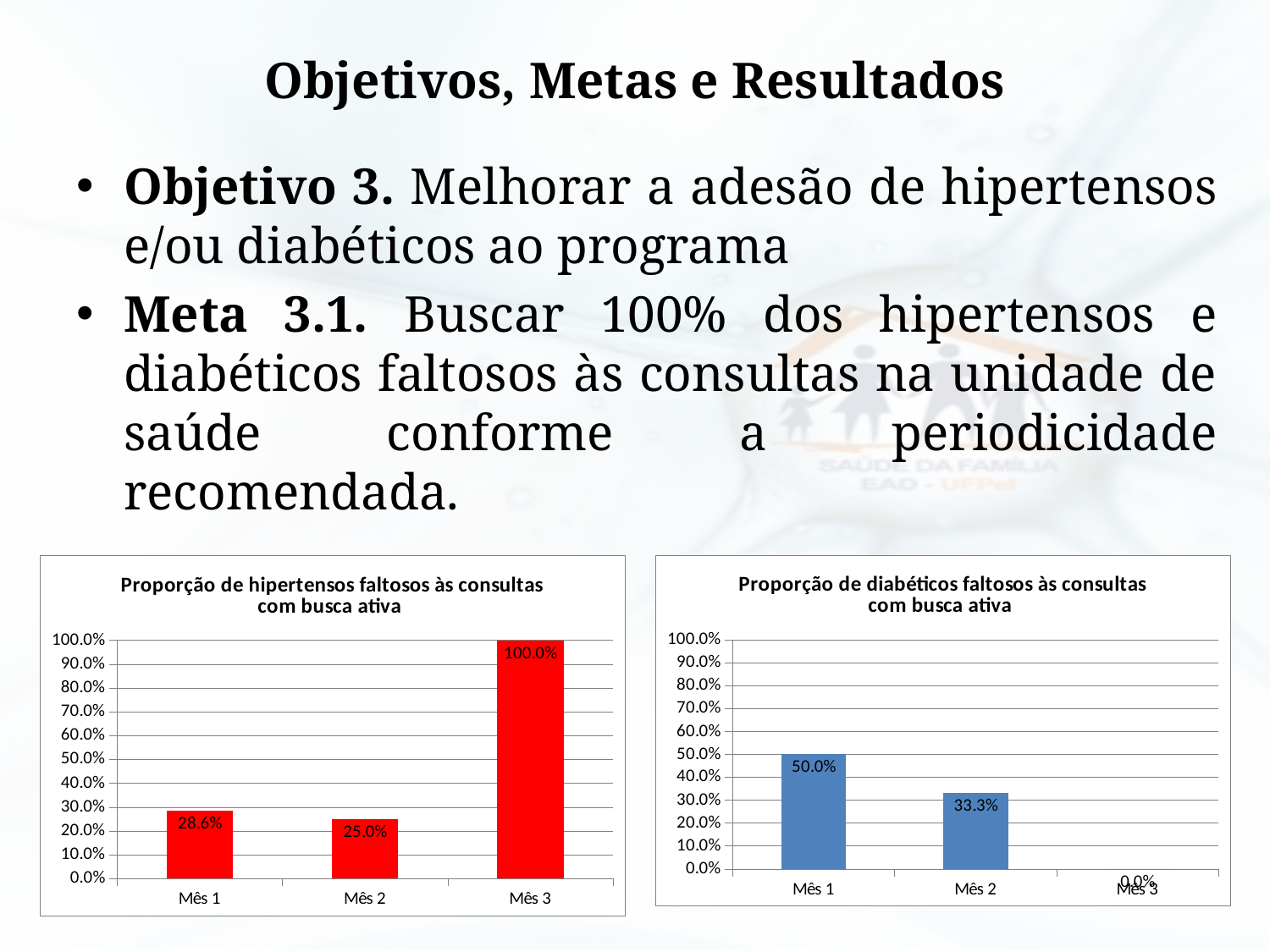
In the chart 'Proporção de hipertensos faltosos às consultas com busca ativa', which month has the highest value? Mês 3 In the chart 'Proporção de diabéticos faltosos às consultas com busca ativa', what is the value for Mês 1? 50.0% How many months are shown on the x axis of the chart 'Proporção de hipertensos faltosos às consultas com busca ativa'? 3 In the chart 'Proporção de diabéticos faltosos às consultas com busca ativa', what is the difference between the values for Mês 1 and Mês 2? 16.7% In the chart 'Proporção de hipertensos faltosos às consultas com busca ativa', what is the value for Mês 3? 100.0% In the chart 'Proporção de hipertensos faltosos às consultas com busca ativa', what is the value for Mês 1? 28.6% In the chart 'Proporção de diabéticos faltosos às consultas com busca ativa', which month has the highest value? Mês 1 In the chart 'Proporção de hipertensos faltosos às consultas com busca ativa', what is the difference between the values for Mês 3 and Mês 2? 75.0% In the chart 'Proporção de diabéticos faltosos às consultas com busca ativa', what is the value for Mês 2? 33.3% In the chart 'Proporção de diabéticos faltosos às consultas com busca ativa', which is larger, the value for Mês 1 or Mês 2? Mês 1 What kind of chart is 'Proporção de diabéticos faltosos às consultas com busca ativa'? Bar chart In the chart 'Proporção de hipertensos faltosos às consultas com busca ativa', which month has the lowest value? Mês 2